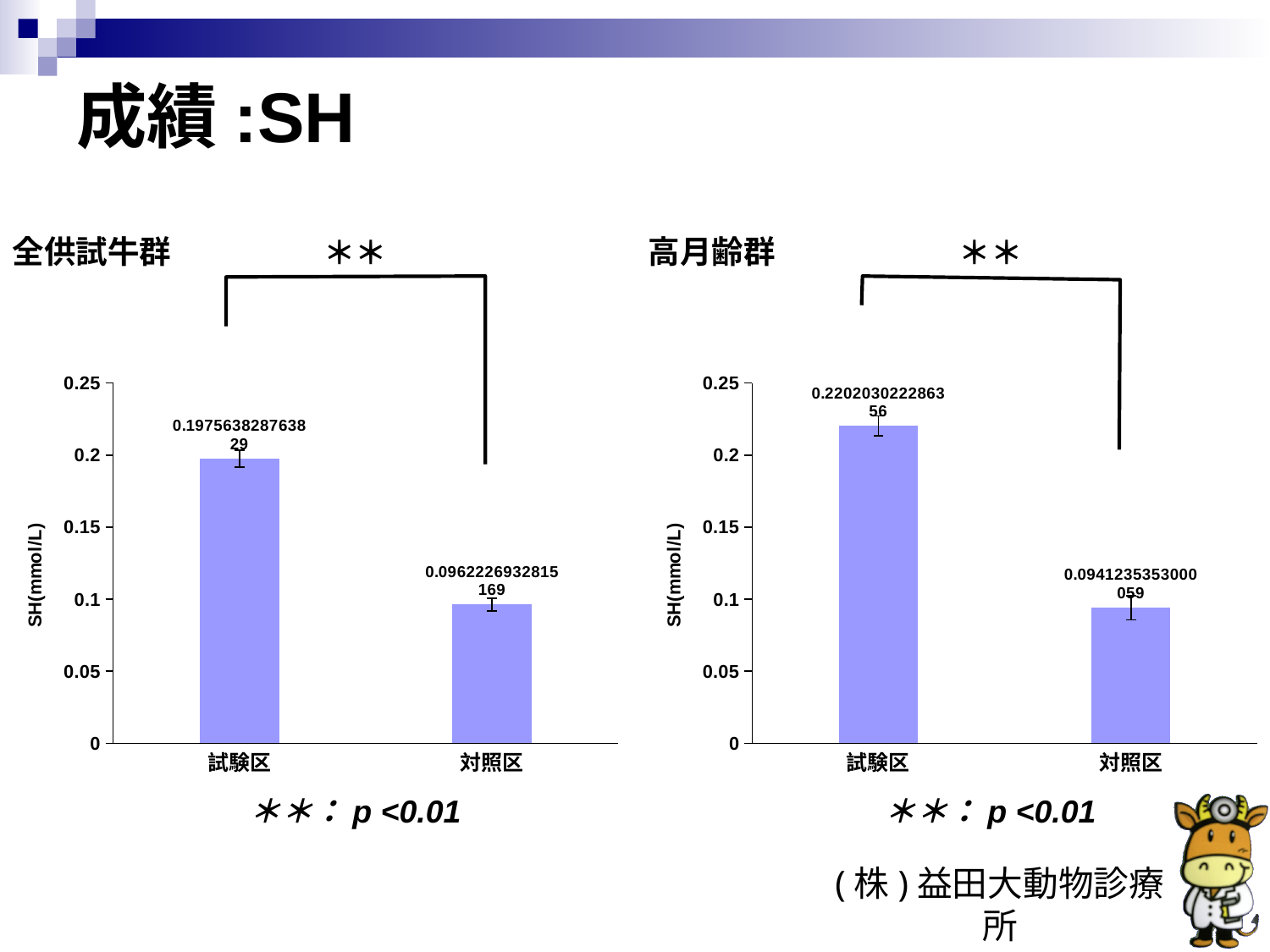
In the right chart (高月齢群), is the SH value for 試験区 greater or less than 0.2? greater In the right chart (高月齢群), what is the SH value for 試験区? 0.220203022286356 What is the y-axis label of the left chart (全供試牛群)? SH(mmol/L) In the left chart (全供試牛群), what is the SH value for 試験区? 0.197563828763829 Is the 試験区 value in the right chart (高月齢群) larger or smaller than the 試験区 value in the left chart (全供試牛群)? larger In the left chart (全供試牛群), which group has the higher SH value? 試験区 In the right chart (高月齢群), what is the SH value for 対照区? 0.0941235353000059 In the left chart (全供試牛群), is the SH value for 対照区 greater or less than 0.1? less In the right chart (高月齢群), which group has the lowest SH value? 対照区 What kind of chart is the right chart (高月齢群)? bar chart How many categories are shown on the x axis of the left chart (全供試牛群)? 2 In the left chart (全供試牛群), what is the SH value for 対照区? 0.0962226932815169